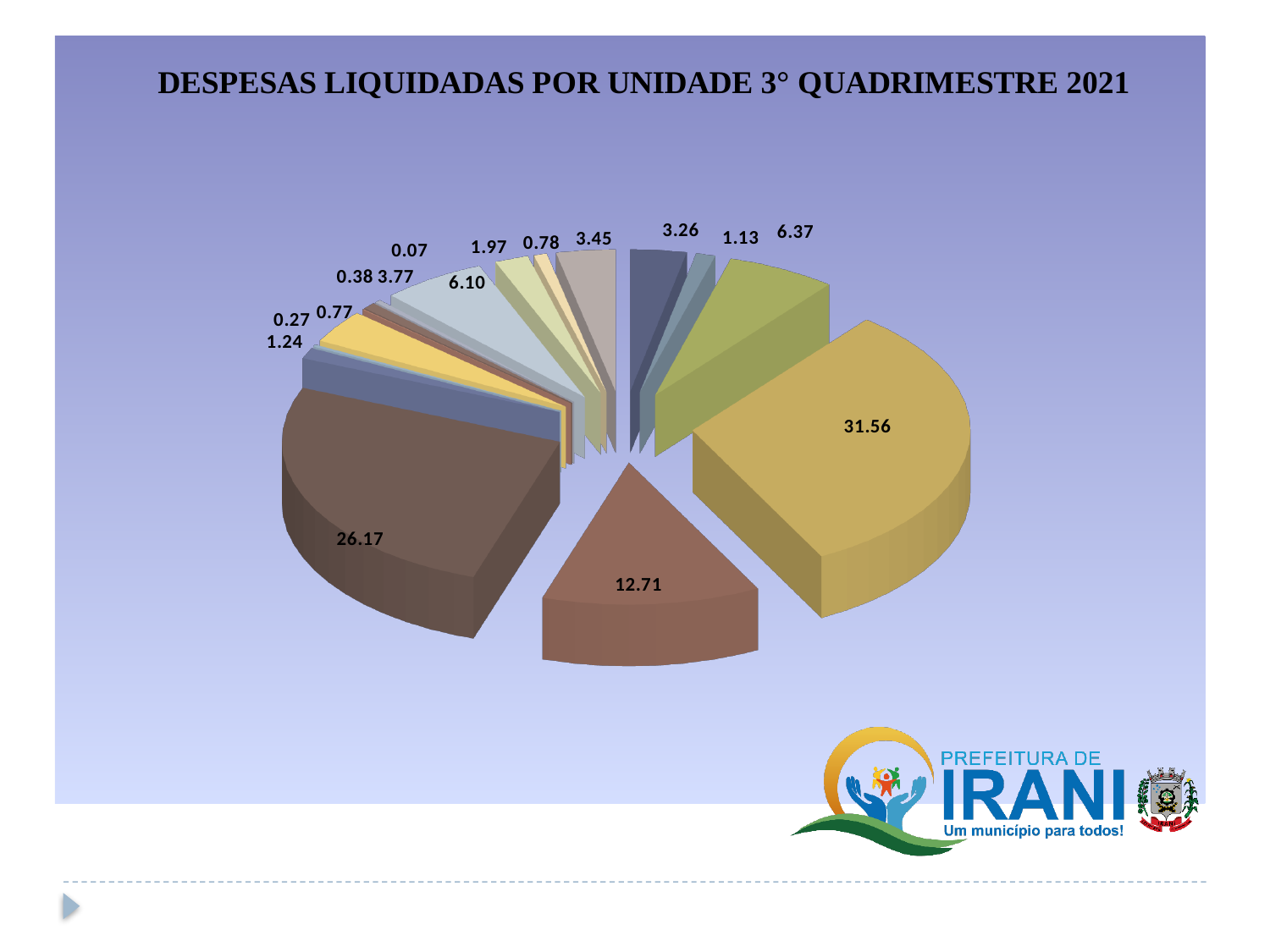
What is the combined value of the three largest slices (31.56, 26.17 and 12.71)? 70.44 How many slices does the pie chart have? 16 What is the difference between the largest slice (31.56) and the second-largest slice (26.17)? 5.39 What is the value of the largest slice in the pie chart? 31.56 What kind of chart is shown on the slide? pie chart What colour is the largest slice of the pie chart? gold/yellow What is the value of the smallest slice in the pie chart? 0.07 Which is larger, the slice labelled 12.71 or the slice labelled 6.37? 12.71 What is the value of the second-largest slice in the pie chart? 26.17 What is the title of the chart? DESPESAS LIQUIDADAS POR UNIDADE 3° QUADRIMESTRE 2021 How many slices in the pie chart have a value greater than 10? 3 What is the difference between the slices labelled 12.71 and 6.37? 6.34